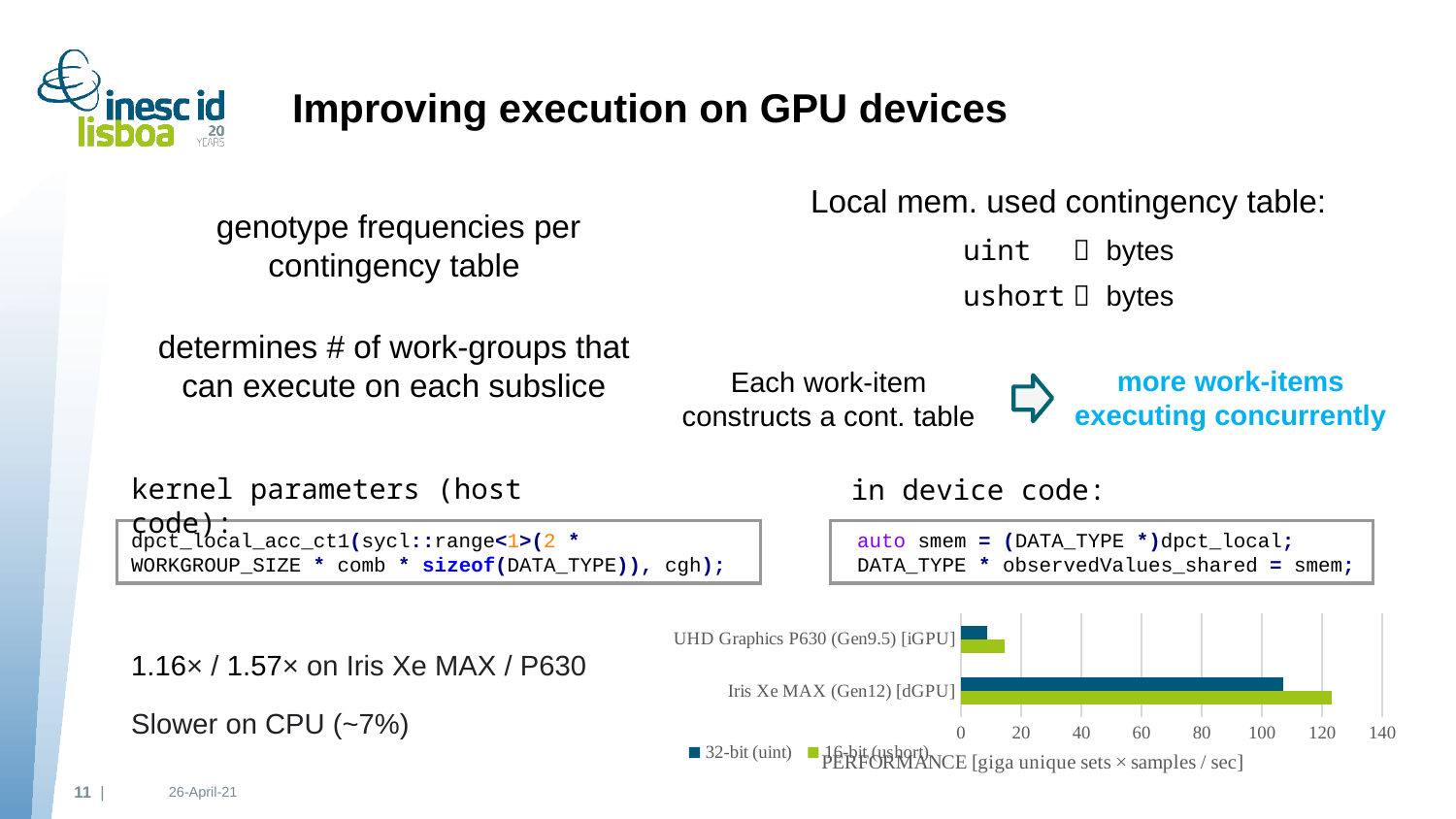
Which series in the performance chart is drawn in green? 16-bit (ushort) What is the label of the horizontal axis in the performance chart? PERFORMANCE [giga unique sets × samples / sec] How many series does the legend of the performance chart list? 2 How many device categories are plotted in the performance chart? 2 Is the 32-bit (uint) value for UHD Graphics P630 (Gen9.5) [iGPU] greater or less than 20? less What kind of chart is shown at the bottom right of the slide? bar chart For UHD Graphics P630 (Gen9.5) [iGPU], which series has the larger bar, 32-bit (uint) or 16-bit (ushort)? 16-bit (ushort) Which device has the highest performance in the chart? Iris Xe MAX (Gen12) [dGPU] Is the 32-bit (uint) value for Iris Xe MAX (Gen12) [dGPU] greater or less than 120? less Is the 16-bit (ushort) value for Iris Xe MAX (Gen12) [dGPU] greater or less than 100? greater Which device has the lowest performance in the chart? UHD Graphics P630 (Gen9.5) [iGPU] For Iris Xe MAX (Gen12) [dGPU], which series has the larger bar, 32-bit (uint) or 16-bit (ushort)? 16-bit (ushort)